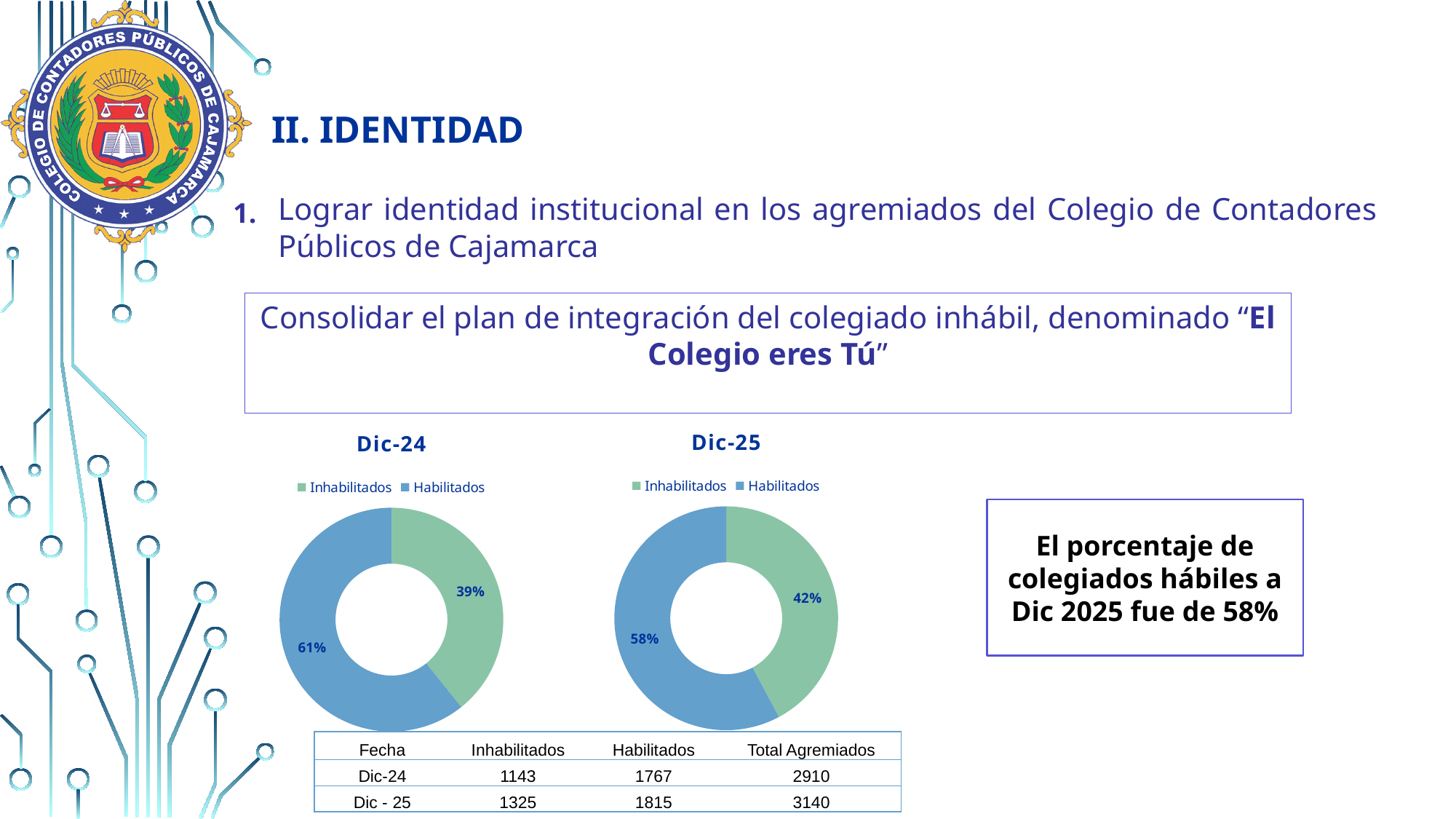
In the Dic-24 chart, what is the difference in percentage points between Habilitados and Inhabilitados? 22 percentage points How many entries does the legend of the Dic-24 chart list? 2 In the Dic-25 chart, which slice is larger, Inhabilitados or Habilitados? Habilitados In the Dic-24 chart, what percentage is shown for Inhabilitados? 39% In the Dic-25 chart, what percentage is shown for Habilitados? 58% How many slices does the Dic-25 chart have? 2 In the Dic-25 chart, what percentage is shown for Inhabilitados? 42% In the Dic-25 chart, what colour is the Habilitados slice? Blue What is the title of the chart on the right? Dic-25 In the Dic-24 chart, which category has the smallest share? Inhabilitados What kind of chart is the Dic-24 chart? Donut (pie) chart In the Dic-24 chart, what percentage is shown for Habilitados? 61%